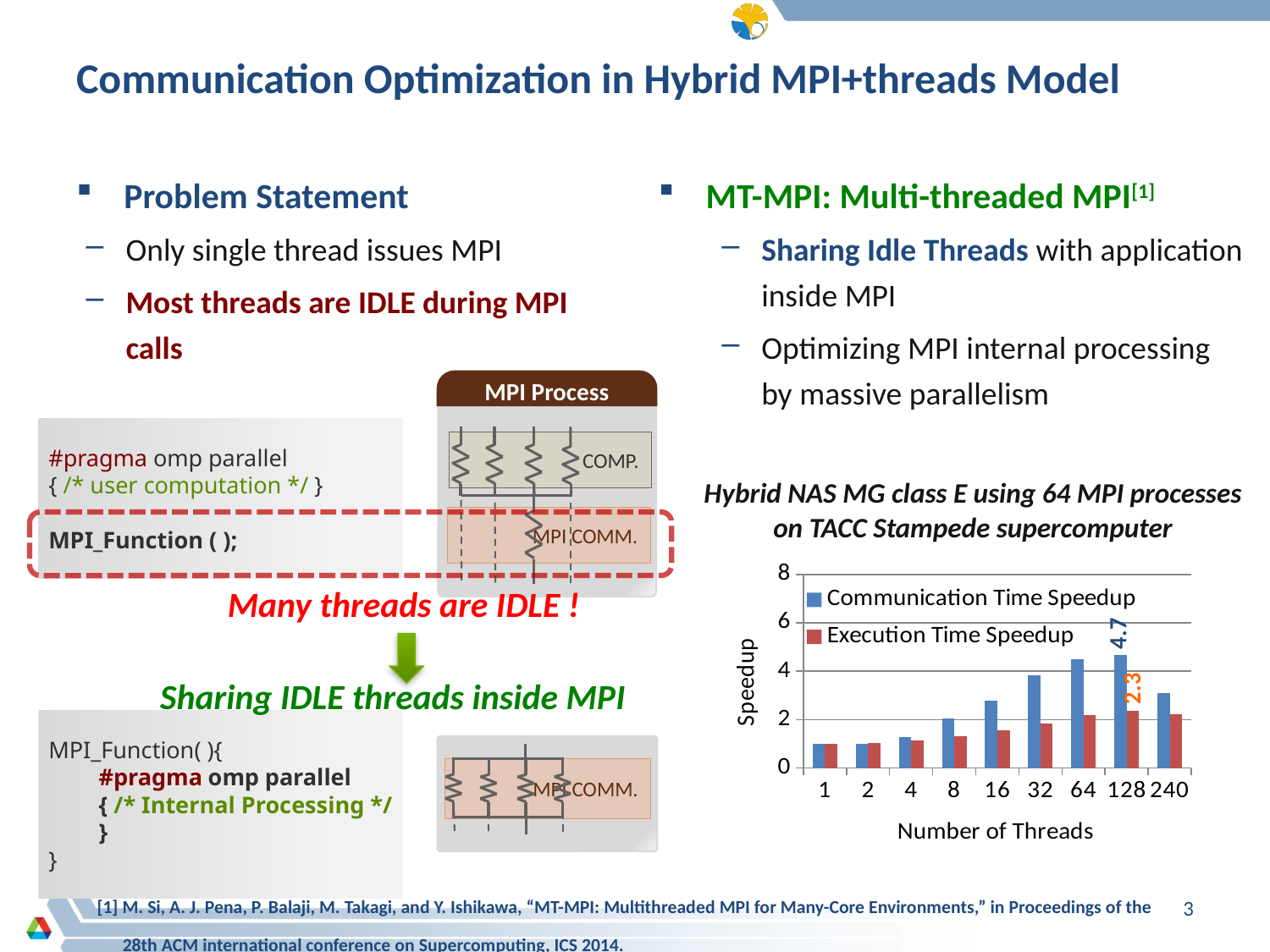
Which is larger at 240 threads, the Communication Time Speedup or the Execution Time Speedup? Communication Time Speedup Is the Communication Time Speedup at 64 threads greater or less than 4? greater How many series does the chart legend list? 2 What is the label of the x axis of the chart? Number of Threads Is the Execution Time Speedup at 32 threads greater or less than 2? less What type of chart is shown on the slide? bar chart What is the difference between the Communication Time Speedup and the Execution Time Speedup at 128 threads? 2.3 What is the label of the y axis of the chart? Speedup At which number of threads is the Communication Time Speedup highest? 128 What is the Execution Time Speedup at 128 threads? 2.3 How many thread-count categories are shown on the x axis of the chart? 9 What is the Communication Time Speedup at 128 threads? 4.7